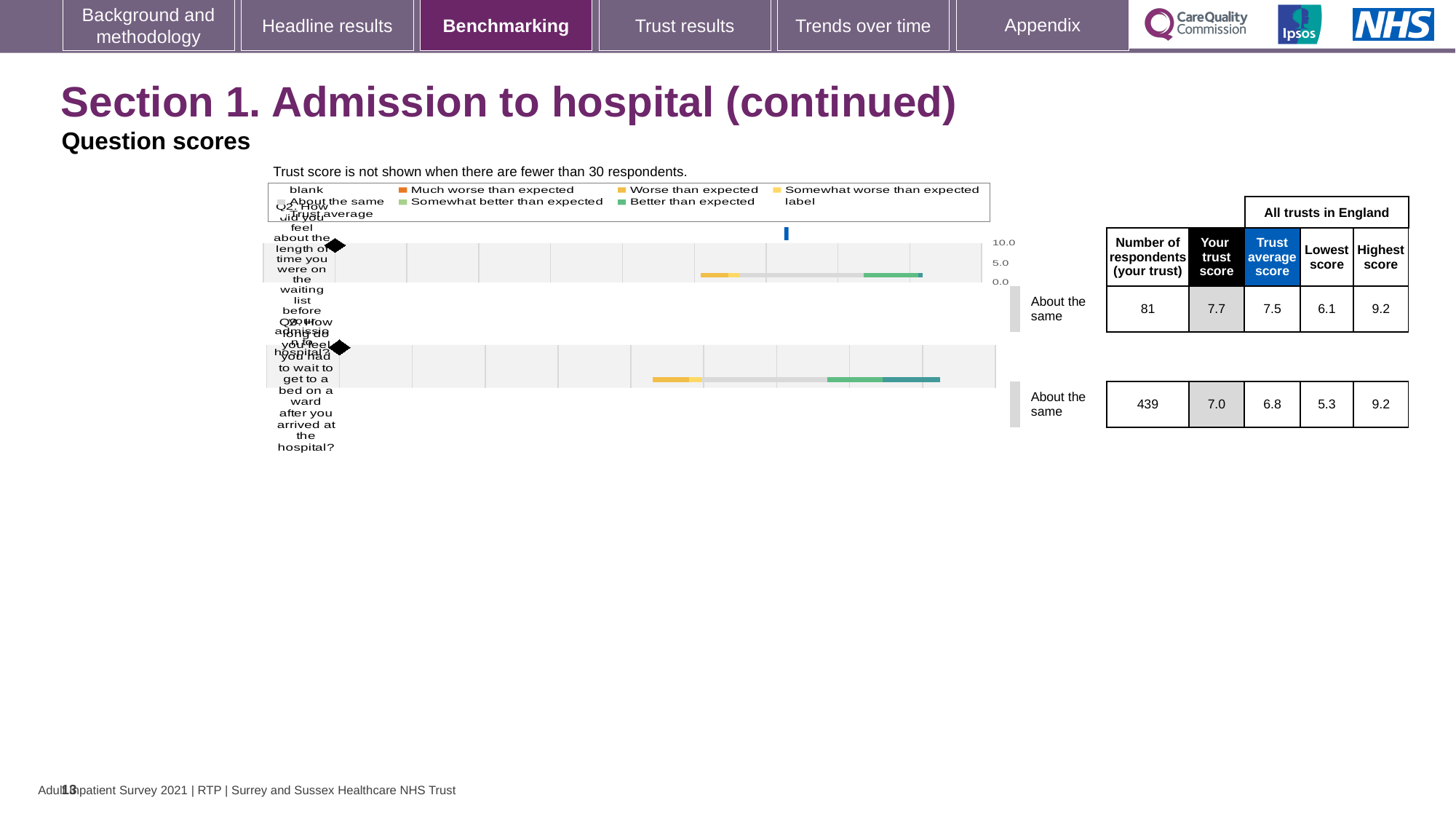
What is the trust score for Q2 (how did you feel about the length of time you were on the waiting list before admission)? 7.7 What is the difference between the highest and lowest scores across all trusts in England for Q2? 3.1 What is the highest score among all trusts in England for Q2? 9.2 Which question has the higher trust score, Q2 or Q3? Q2 What is the difference between the trust score and the trust average score for Q3? 0.2 What is the lowest score among all trusts in England for Q3? 5.3 Is the trust score for Q2 greater or less than 5.0 on the chart axis? greater What is the trust score for Q3 (how long did you feel you had to wait to get to a bed on a ward after you arrived at the hospital)? 7.0 What is the trust average score across all trusts in England for Q2? 7.5 What benchmark category is the trust's Q3 score placed in? About the same How many respondents answered Q3 for this trust? 439 How many questions are plotted on the slide? 2